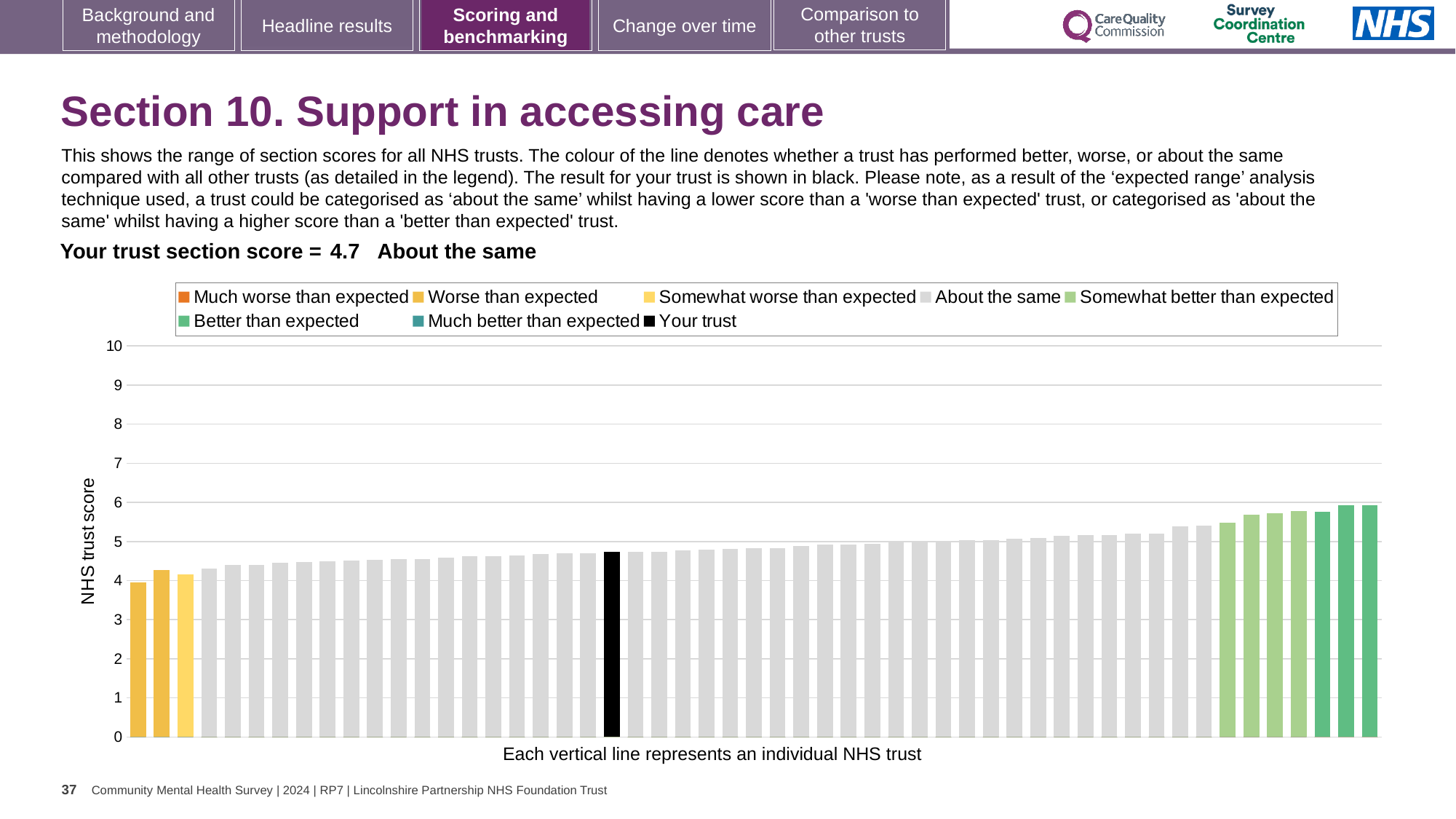
Is the value of the black bar (your trust) greater or less than 5? less How many entries does the chart legend list? 8 Which performance category is your trust placed in according to the slide? About the same Is the value of the tallest bar greater or less than 5? greater Do the bar values rise or fall from left to right along the x axis? rise How many bars are coloured in the 'Better than expected' dark green colour? 3 Is the value of the shortest bar greater or less than 5? less How many bars are coloured in the 'Worse than expected' yellow colour? 2 What is the section score for your trust shown on the slide? 4.7 What kind of chart is shown on the slide? bar chart What is the label on the vertical axis of the chart? NHS trust score